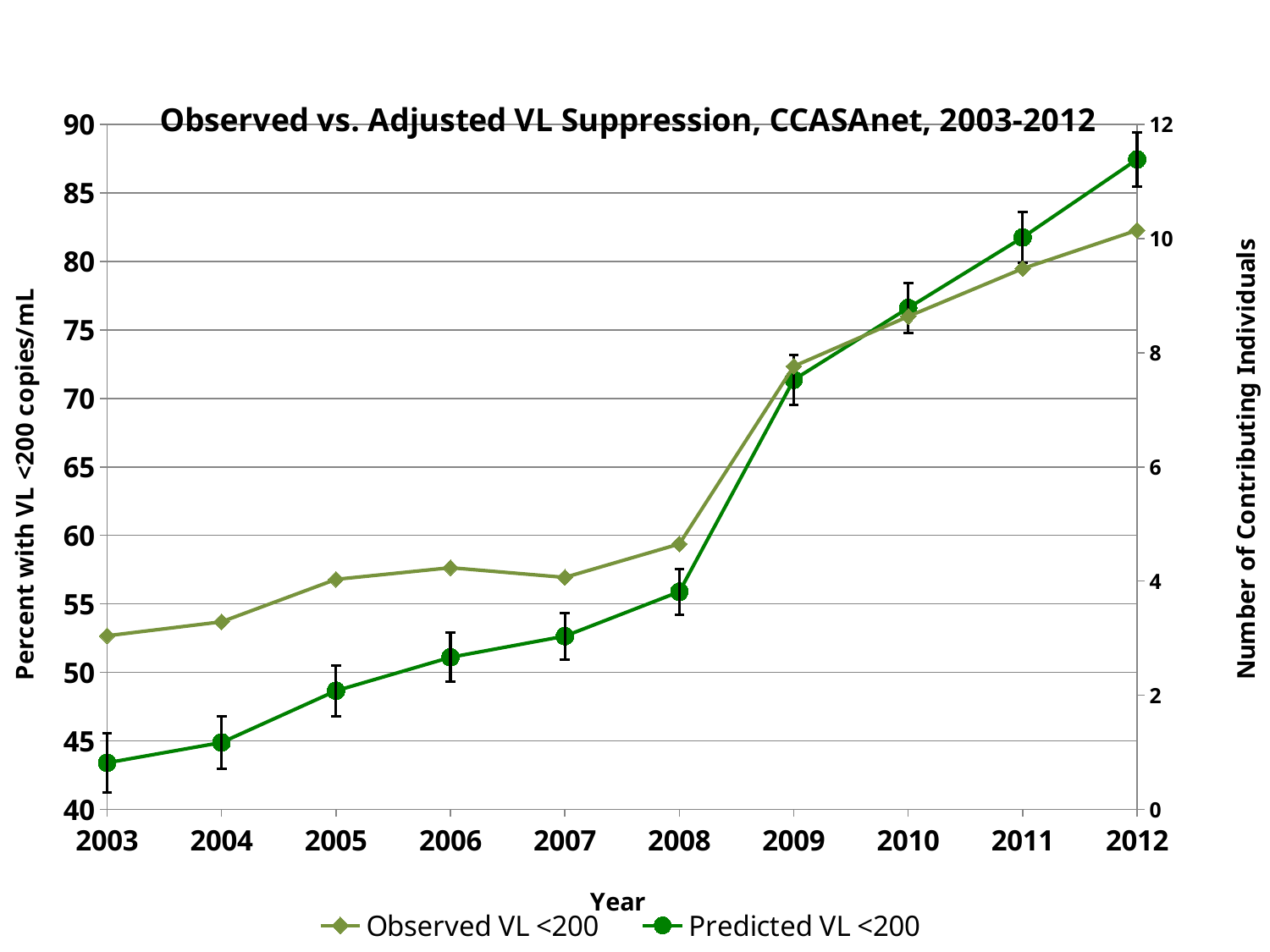
In 2012, which series has the larger value, Observed VL <200 or Predicted VL <200? Predicted VL <200 In 2003, which series has the larger value, Observed VL <200 or Predicted VL <200? Observed VL <200 How many series does the legend list? 2 What is the title of the chart? Observed vs. Adjusted VL Suppression, CCASAnet, 2003-2012 How many years are plotted along the x axis? 10 Is the Observed VL <200 value for 2003 greater or less than 50? greater In which year is the Predicted VL <200 value lowest? 2003 Do the Observed VL <200 values generally rise or fall from 2003 to 2012? rise Is the Predicted VL <200 value for 2012 greater or less than 85? greater What kind of chart is shown on the slide? line chart Is the Predicted VL <200 value for 2003 greater or less than 45? less